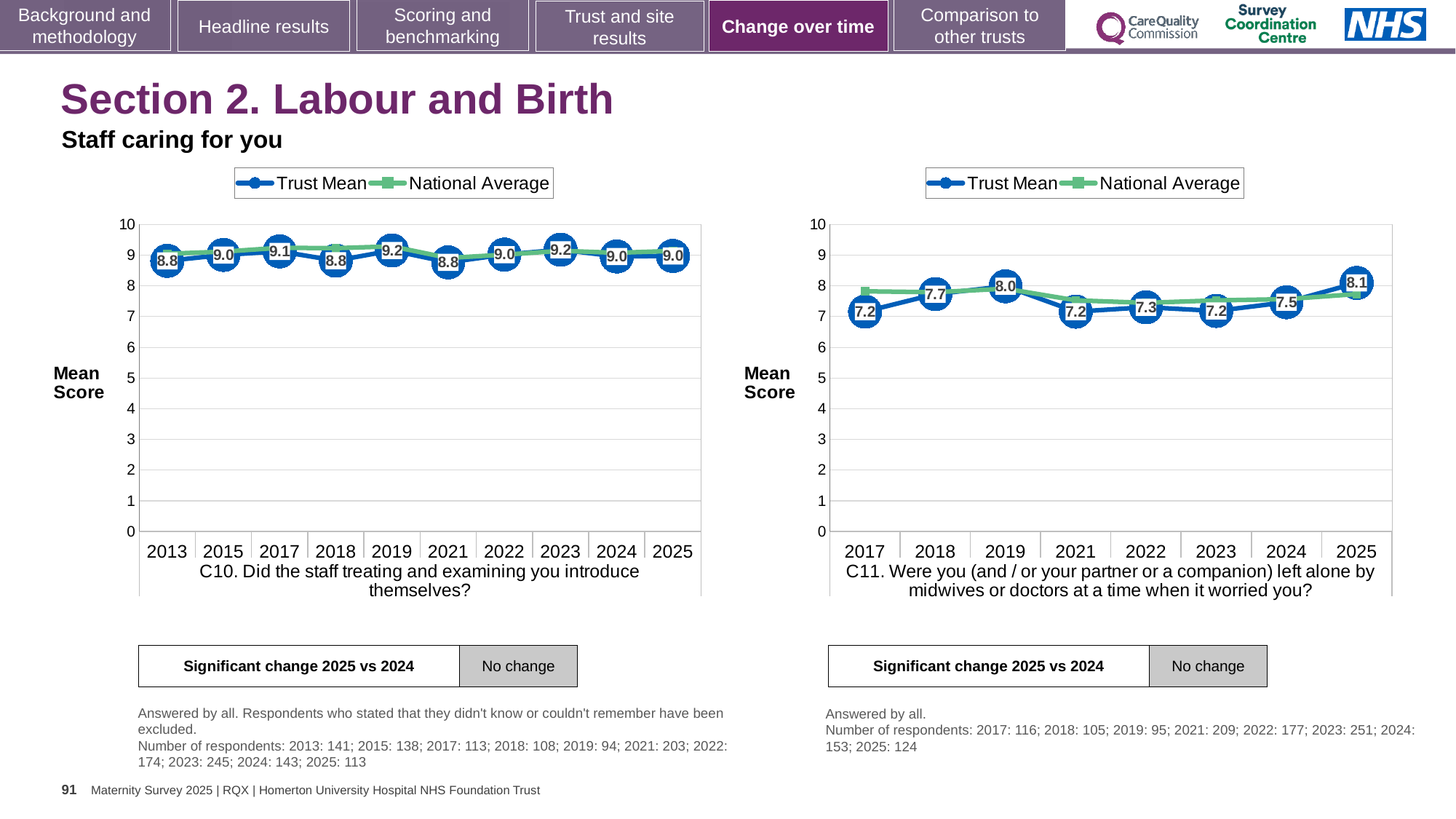
How many series does the legend of the right chart (C11) list? 2 In the right chart (C11), does the Trust Mean rise or fall from 2023 to 2025? Rise In the right chart (C11), what is the Trust Mean score for 2021? 7.2 What kind of chart is the left chart (C10)? Line chart How many years are plotted on the x axis of the left chart (C10)? 10 In the right chart (C11), is the National Average value for 2017 greater or less than 7? greater In the left chart (C10), what is the difference between the Trust Mean scores for 2019 and 2013? 0.4 In the right chart (C11), what is the difference between the Trust Mean scores for 2025 and 2017? 0.9 In the right chart (C11), which year has the highest Trust Mean score? 2025 In the left chart (C10), what is the Trust Mean score for 2019? 9.2 How many years are plotted on the x axis of the right chart (C11)? 8 In the right chart (C11), which year has the larger Trust Mean score, 2019 or 2021? 2019